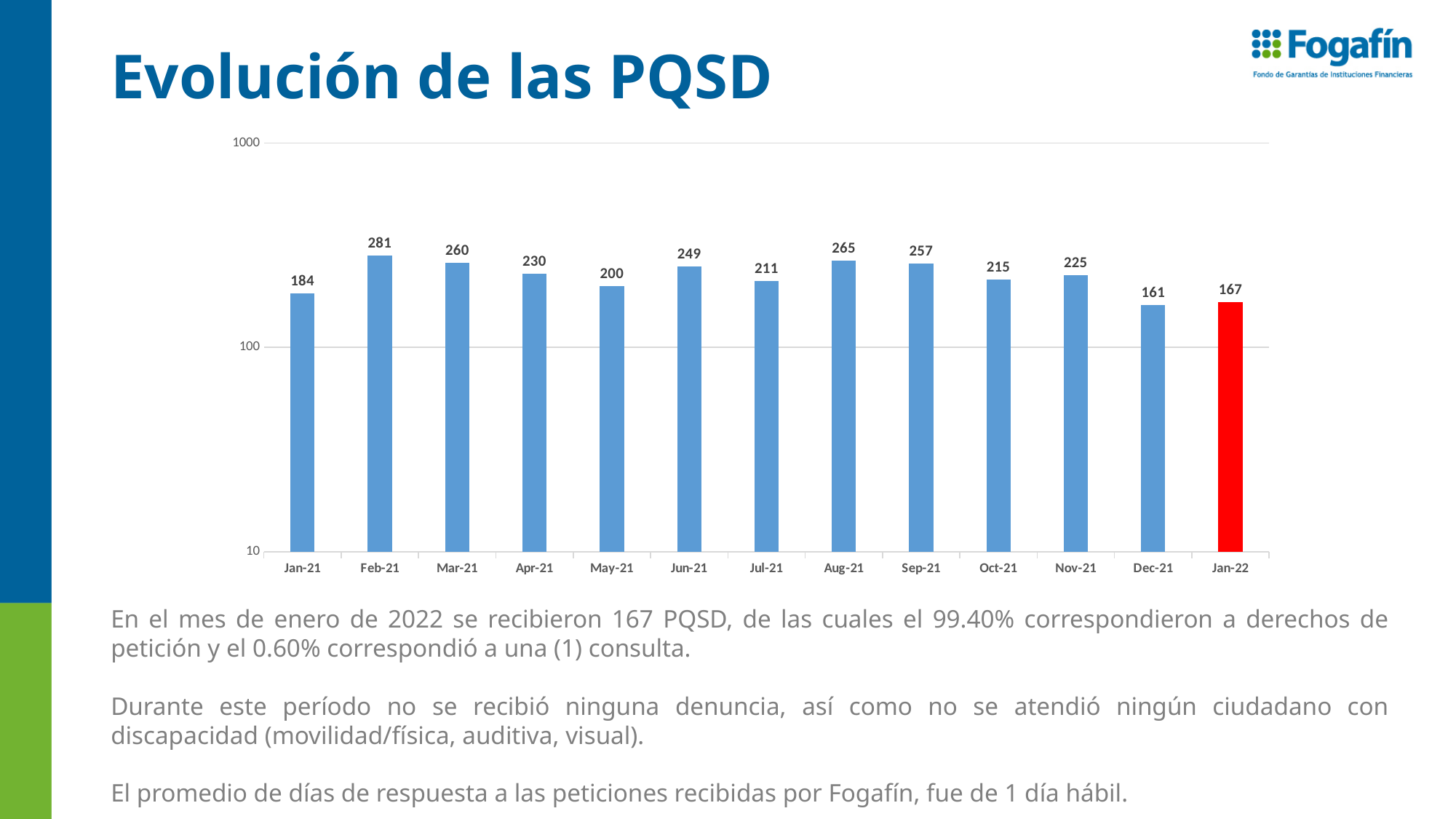
Do the values rise or fall from Nov-21 to Dec-21? fall What is the value for Aug-21? 265 Which is larger, the value for Jun-21 or the value for Sep-21? Sep-21 How many months are shown on the x axis? 13 Which month has the highest value? Feb-21 What kind of chart is shown on the slide? bar chart Is the value for May-21 greater or less than 100? greater Which month has the lowest value? Dec-21 What is the difference between the values for Feb-21 and Dec-21? 120 Which bar is coloured red instead of blue? Jan-22 What is the value for Feb-21? 281 What is the value for Jan-22? 167